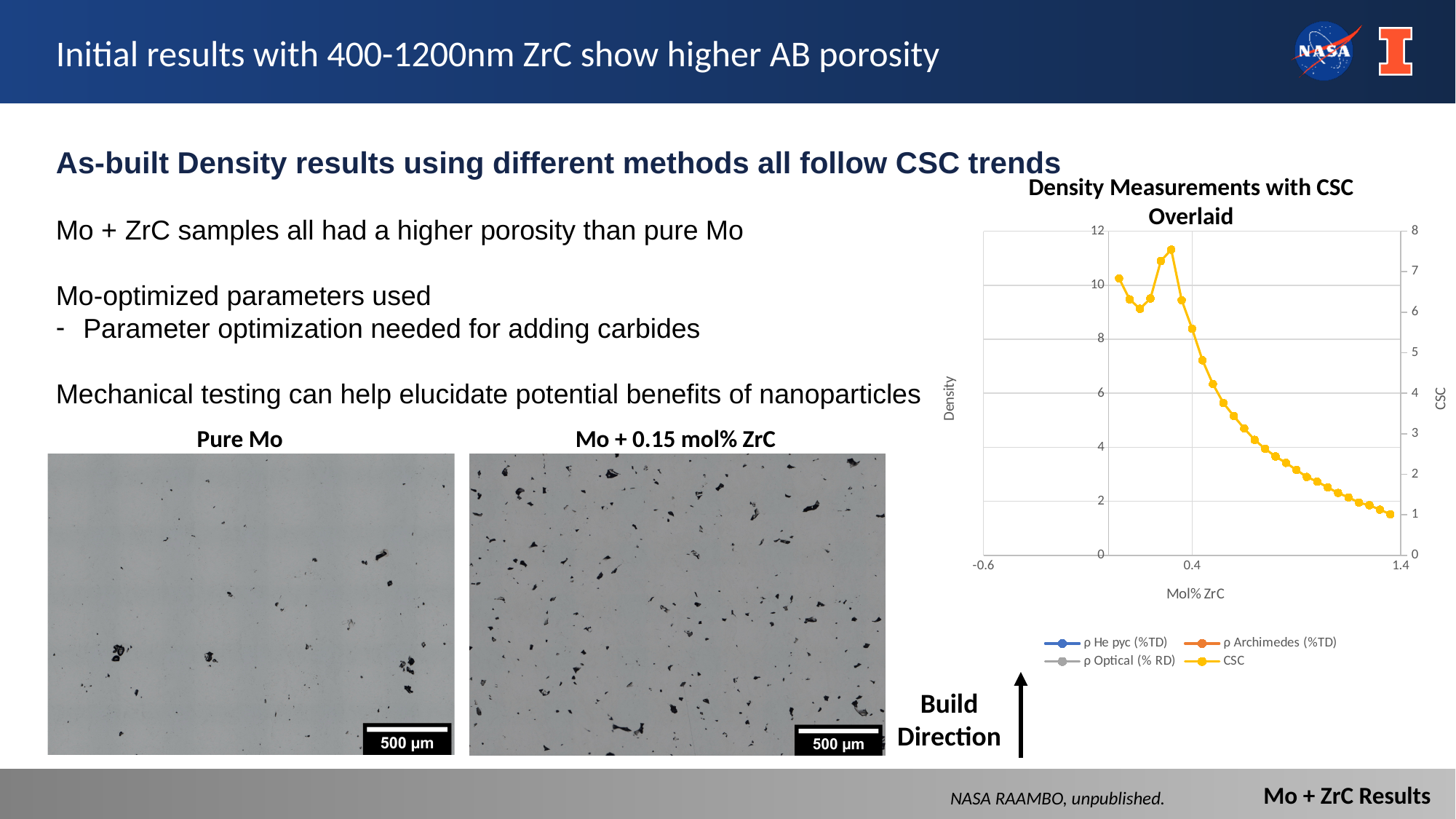
How many series does the legend of the "Density Measurements with CSC Overlaid" chart list? 4 In the "Density Measurements with CSC Overlaid" chart, is the CSC value at the leftmost point greater or less than 6 on the CSC axis? greater In the "Density Measurements with CSC Overlaid" chart, does the CSC series rise or fall along the x axis after its peak? fall In the "Density Measurements with CSC Overlaid" chart, which is larger: the CSC value at the leftmost point or at the rightmost point? leftmost point In the "Density Measurements with CSC Overlaid" chart, is the CSC value at the rightmost point greater or less than 2 on the CSC axis? less What kind of chart is the "Density Measurements with CSC Overlaid" chart? line chart In the "Density Measurements with CSC Overlaid" chart, is the highest CSC value greater or less than 7 on the CSC axis? greater What is the title of the chart on the right side of the slide? Density Measurements with CSC Overlaid What is the label of the x axis of the "Density Measurements with CSC Overlaid" chart? Mol% ZrC